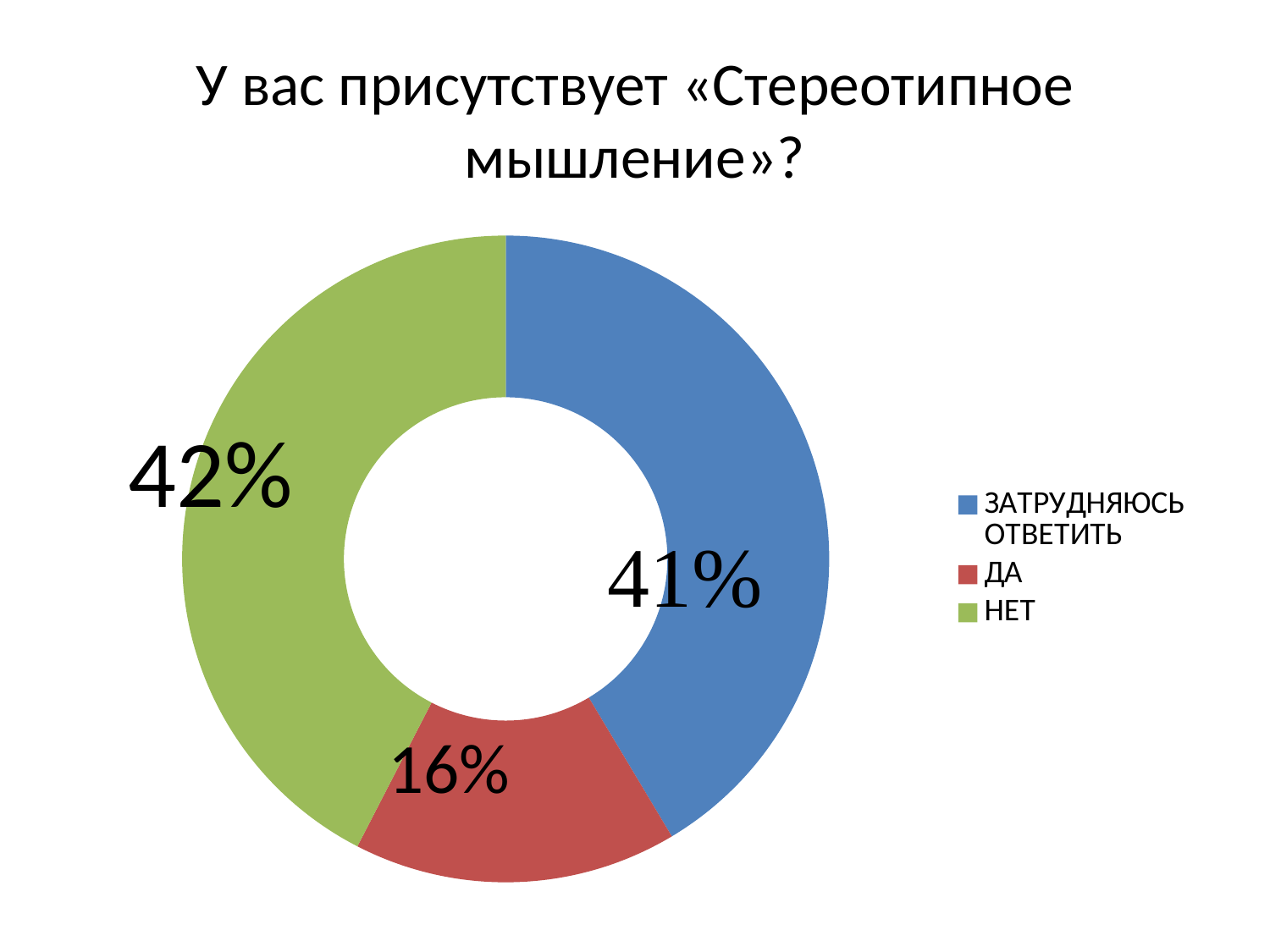
What percentage of respondents answered НЕТ? 42% What kind of chart is shown on the slide? doughnut chart Which answer has the largest share of the chart? НЕТ Which answer has the smallest share of the chart? ДА What colour represents the answer ДА in the chart? red What is the title of the slide? У вас присутствует «Стереотипное мышление»? How many categories does the chart show? 3 What is the difference in percentage points between НЕТ and ДА? 26 Which is larger, the share for ДА or the share for ЗАТРУДНЯЮСЬ ОТВЕТИТЬ? ЗАТРУДНЯЮСЬ ОТВЕТИТЬ What percentage of respondents answered ДА? 16% What is the difference in percentage points between НЕТ and ЗАТРУДНЯЮСЬ ОТВЕТИТЬ? 1 What percentage of respondents answered ЗАТРУДНЯЮСЬ ОТВЕТИТЬ? 41%